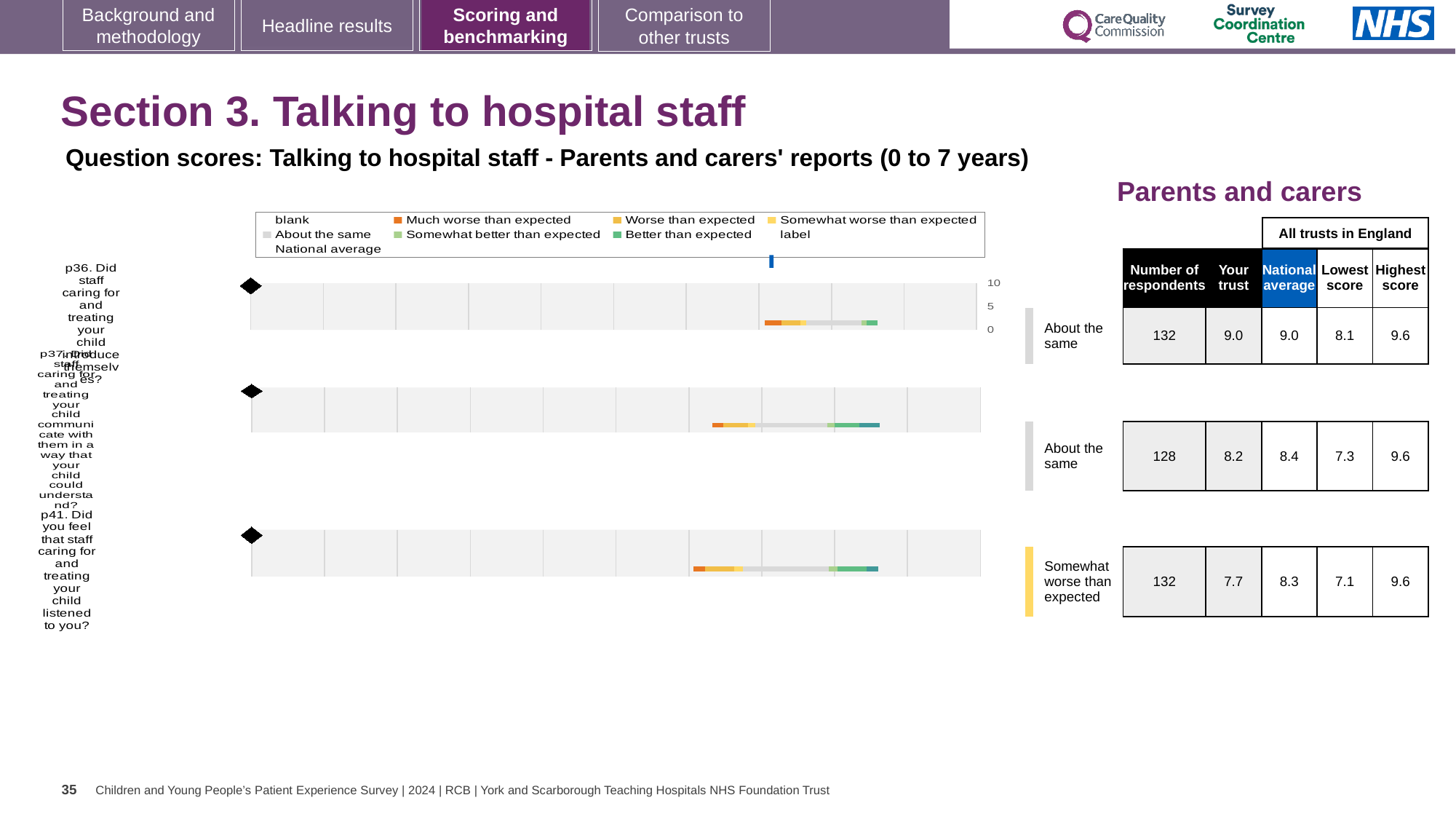
What is the highest score across all trusts in England for question p37? 9.6 Which question has the lowest 'Your trust' score? p41 What kind of chart is used to show the question scores on this slide? bar chart Which question has the highest 'Your trust' score? p36 What is the difference between the highest score and the lowest score for question p41? 2.5 How many respondents answered question p37? 128 What is the 'Your trust' score for question p36 (Did staff caring for and treating your child introduce themselves)? 9.0 How many survey questions are plotted in the chart? 3 What is the maximum value shown on the chart's score axis? 10 What is the national average score for question p41 (Did you feel that staff caring for and treating your child listened to you)? 8.3 What benchmark category is shown for question p41? Somewhat worse than expected Which has the higher 'Your trust' score, question p36 or question p41? p36